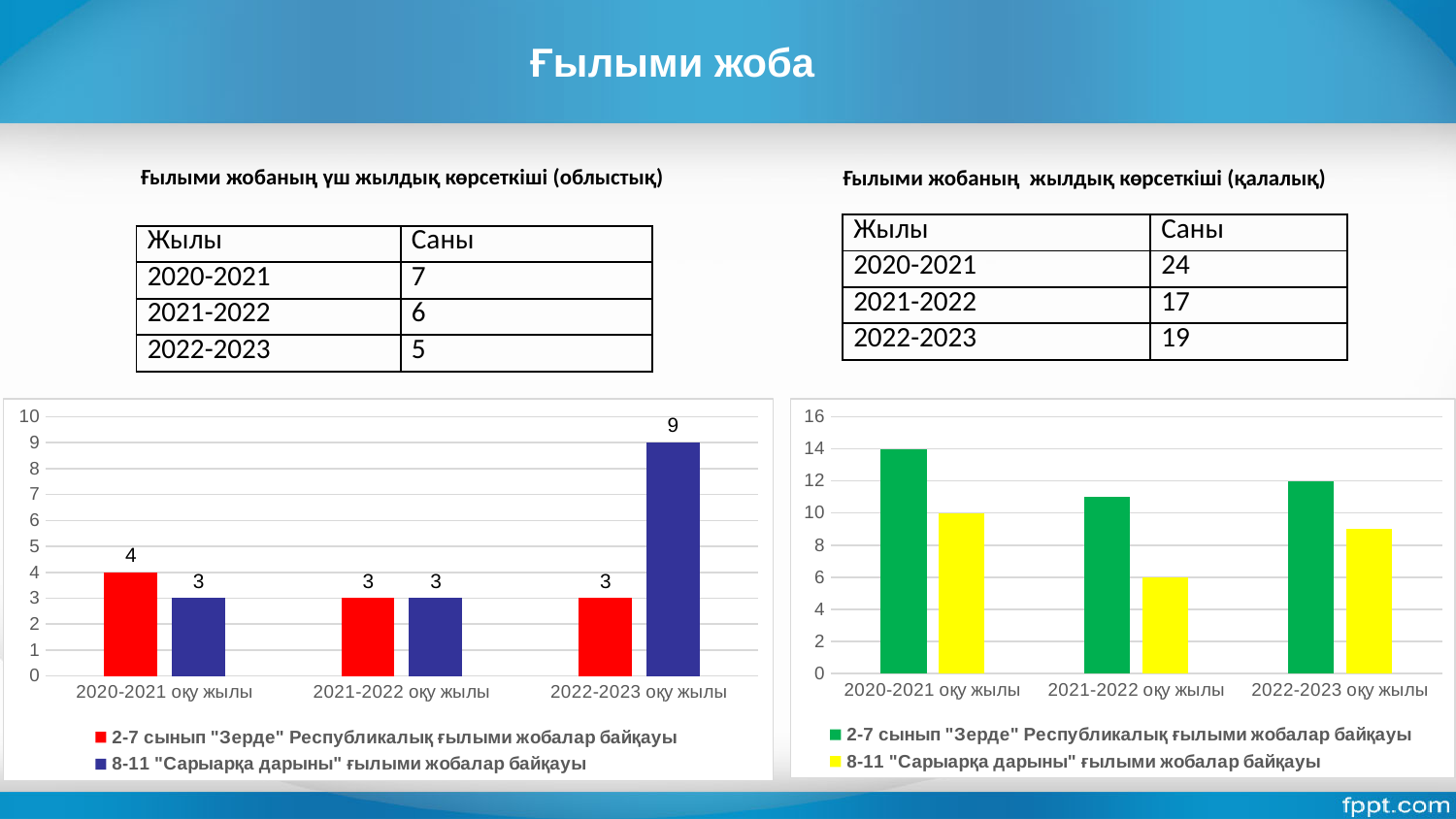
What type of chart is the left chart? bar chart In the left chart, what is the value for the 2-7 сынып "Зерде" series in 2020-2021 оқу жылы? 4 In the left chart, which year has the highest value for the 8-11 "Сарыарқа дарыны" series? 2022-2023 оқу жылы In the right chart, what is the value for the 8-11 "Сарыарқа дарыны" series in 2021-2022 оқу жылы? 6 How many series does the legend of the right chart list? 2 In the right chart, which year has the lowest value for the 8-11 "Сарыарқа дарыны" series? 2021-2022 оқу жылы In the left chart, what is the difference between the two series in 2022-2023 оқу жылы? 6 In the left chart, what is the value for the 8-11 "Сарыарқа дарыны" series in 2022-2023 оқу жылы? 9 In the left chart, which series is larger in 2020-2021 оқу жылы? 2-7 сынып "Зерде" Республикалық ғылыми жобалар байқауы In the right chart, what is the value for the 2-7 сынып "Зерде" series in 2020-2021 оқу жылы? 14 How many year categories are shown on the x axis of the right chart? 3 In the right chart, is the value for the 2-7 сынып "Зерде" series in 2021-2022 оқу жылы greater or less than 10? greater